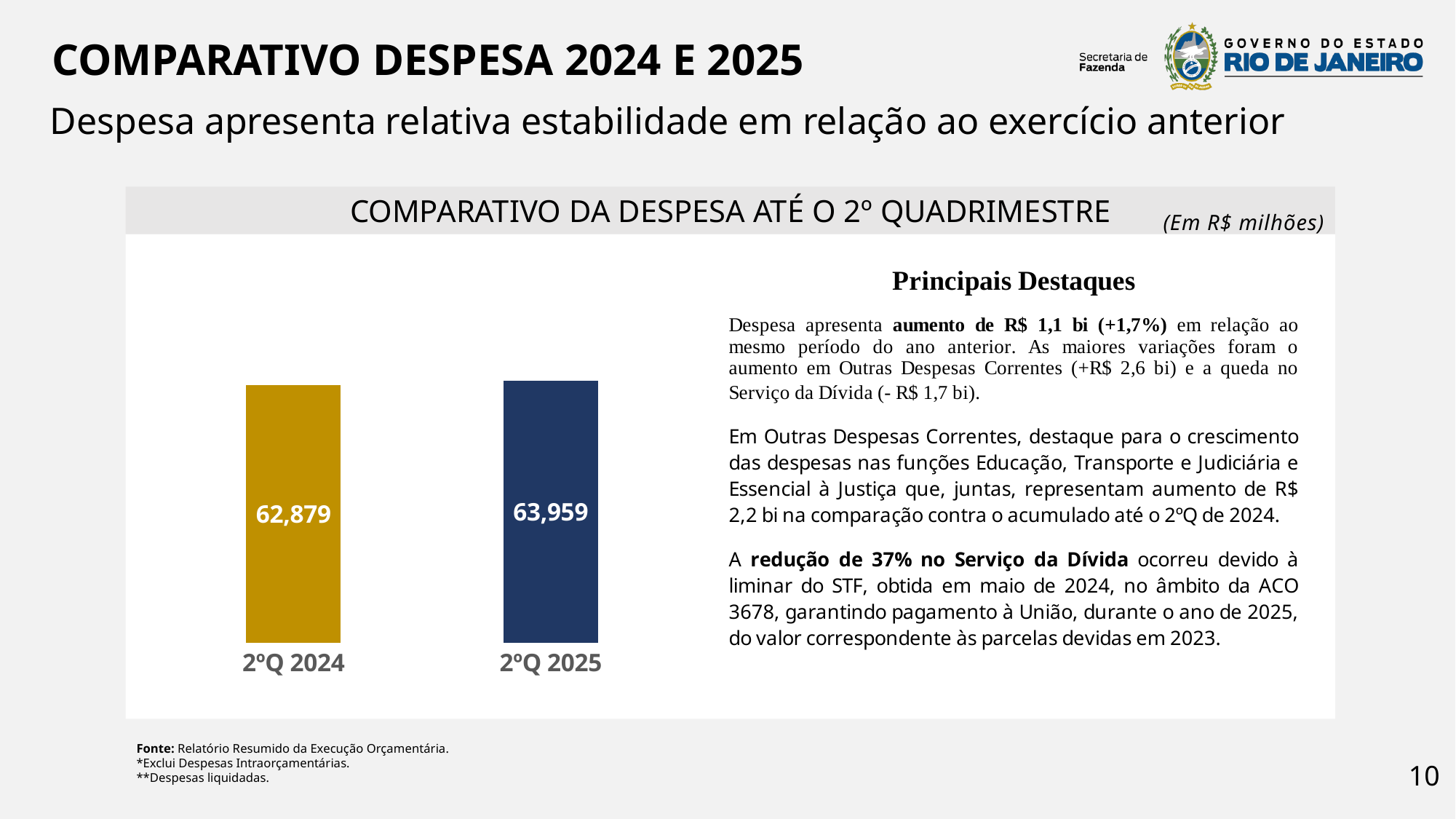
Do the values rise or fall from 2ºQ 2024 to 2ºQ 2025? rise Is the value for 2ºQ 2025 larger or smaller than the value for 2ºQ 2024? larger Which period has the lower value in the chart? 2ºQ 2024 What is the difference between the values for 2ºQ 2025 and 2ºQ 2024? 1,080 Which period has the higher value, 2ºQ 2024 or 2ºQ 2025? 2ºQ 2025 What is the value shown for 2ºQ 2025? 63,959 What is the value shown for 2ºQ 2024? 62,879 How many bars are plotted in the chart? 2 What is the title of the chart? COMPARATIVO DA DESPESA ATÉ O 2º QUADRIMESTRE What kind of chart is shown on the slide? bar chart In what unit are the chart values expressed? R$ milhões